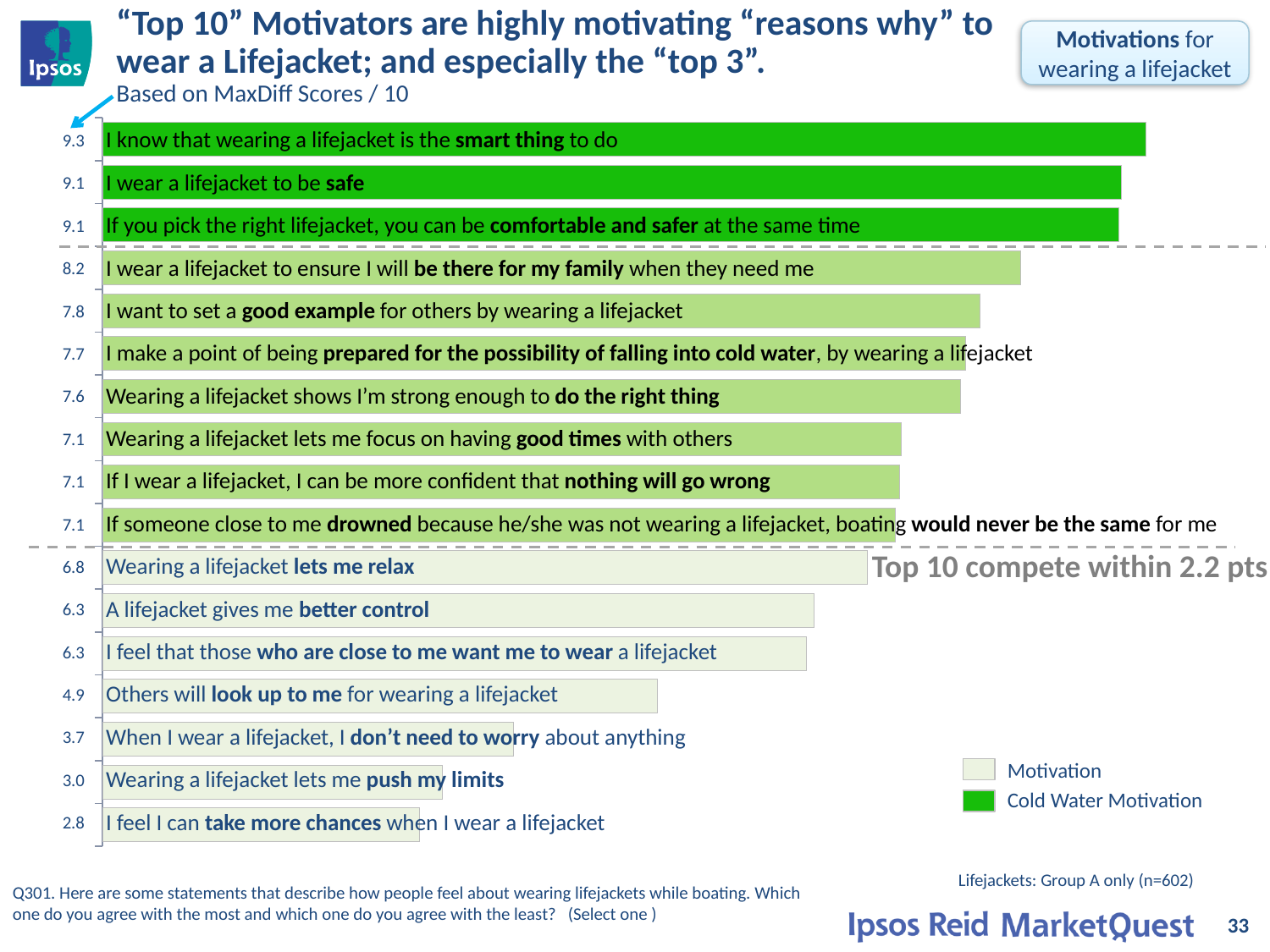
Which has a higher score: "Others will look up to me for wearing a lifejacket" or "When I wear a lifejacket, I don't need to worry about anything"? Others will look up to me for wearing a lifejacket What kind of chart is shown on the slide? Bar chart What is the difference between the score for "I wear a lifejacket to ensure I will be there for my family when they need me" and the score for "Wearing a lifejacket lets me focus on having good times with others"? 1.1 What are the two legend entries in the chart? Motivation and Cold Water Motivation What is the MaxDiff score for "Wearing a lifejacket lets me relax"? 6.8 Which statement has the highest MaxDiff score? I know that wearing a lifejacket is the smart thing to do What is the MaxDiff score for "I want to set a good example for others by wearing a lifejacket"? 7.8 Which statement has the lowest MaxDiff score? I feel I can take more chances when I wear a lifejacket How many entries does the legend list? 2 What is the difference between the highest score (9.3) and the lowest score (2.8)? 6.5 How many statements (bars) are shown in the chart? 17 What is the MaxDiff score for "I wear a lifejacket to be safe"? 9.1